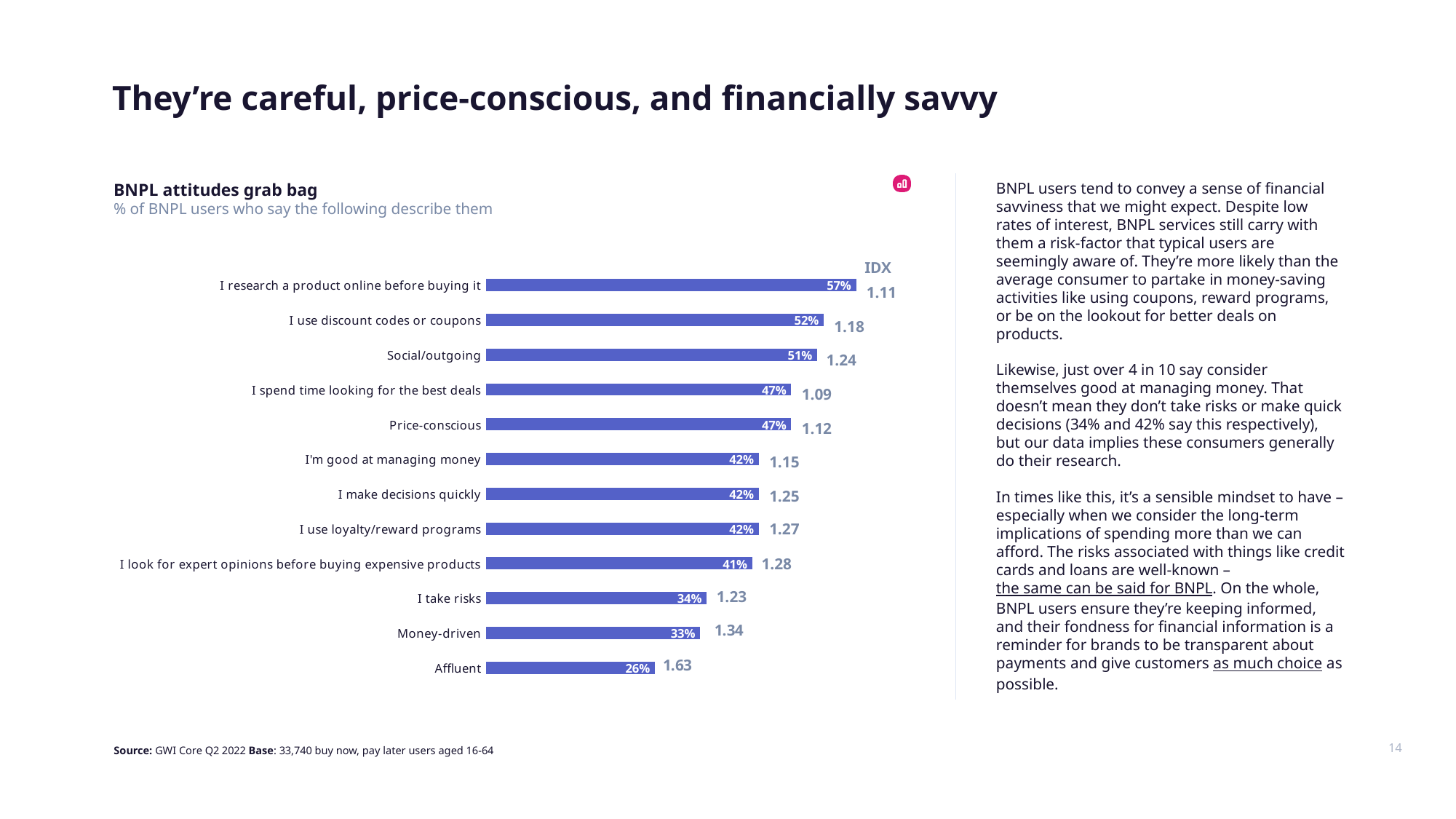
What is the IDX value for 'I spend time looking for the best deals'? 1.09 What percentage of BNPL users describe themselves as 'Money-driven'? 33% What is the difference in percentage points between 'I research a product online before buying it' and 'Affluent'? 31 Which category has the lowest percentage in the chart? Affluent What percentage of BNPL users say 'I research a product online before buying it'? 57% What is the IDX value shown for 'Affluent'? 1.63 Which is larger: the percentage for 'Social/outgoing' or for 'I take risks'? Social/outgoing Which category has the highest percentage in the chart? I research a product online before buying it What is the title of the chart? BNPL attitudes grab bag How many categories are shown in the chart? 12 What percentage of BNPL users say 'I use discount codes or coupons'? 52% What type of chart is used on this slide? Bar chart